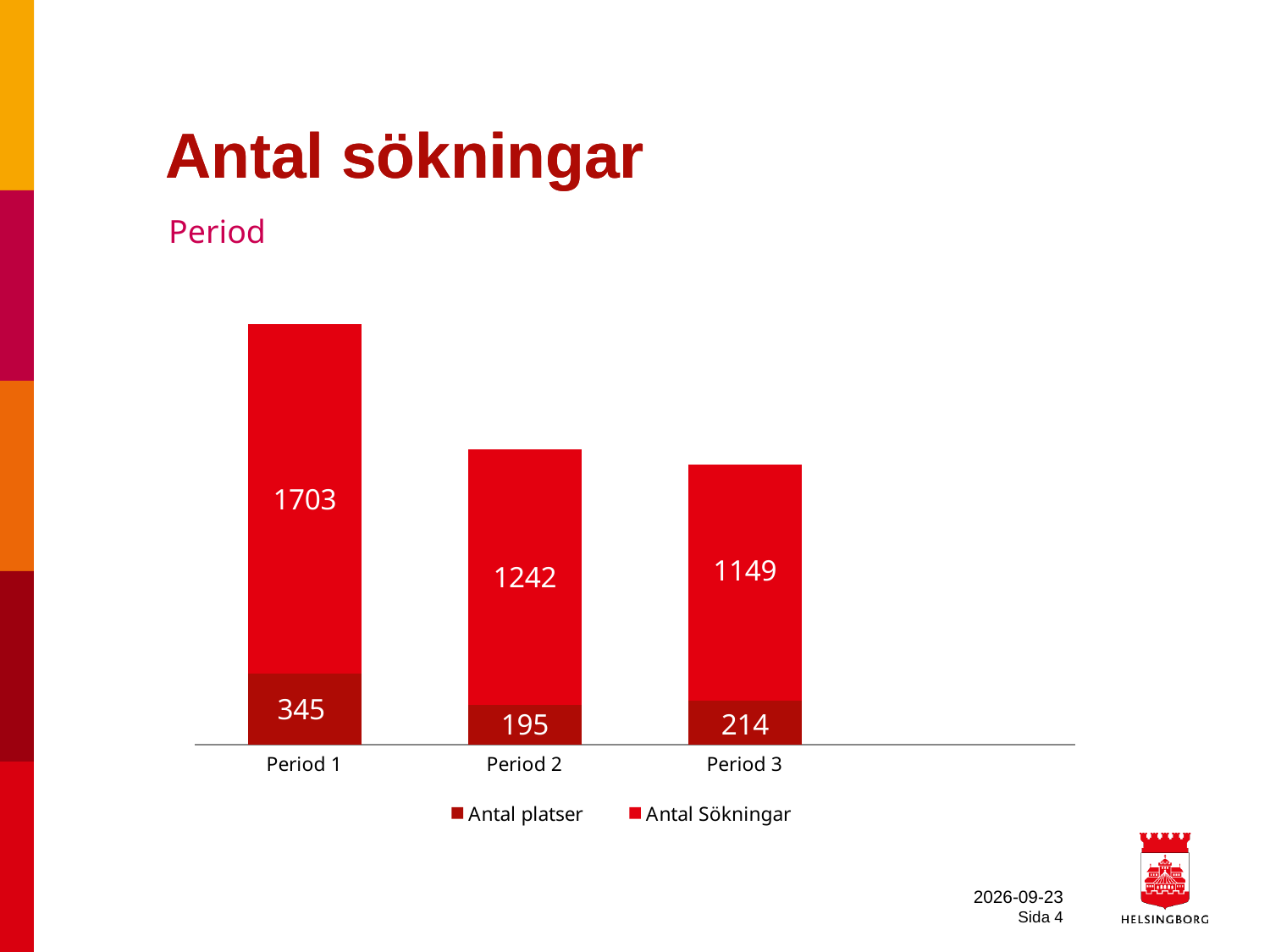
What is the value of Antal platser for Period 3? 214 What is the value of Antal Sökningar for Period 1? 1703 What is the difference between Antal Sökningar in Period 1 and Period 2? 461 What is the value of Antal platser for Period 2? 195 How many periods are shown on the x axis? 3 Which is larger: Antal platser in Period 2 or Antal platser in Period 3? Period 3 What is the total of the stacked bar for Period 1? 2048 Which period has the lowest value for Antal platser? Period 2 What kind of chart is shown on the slide? Stacked bar chart Which period has the highest value for Antal Sökningar? Period 1 Does Antal Sökningar rise or fall from Period 1 to Period 3? Fall How many series does the legend list? 2